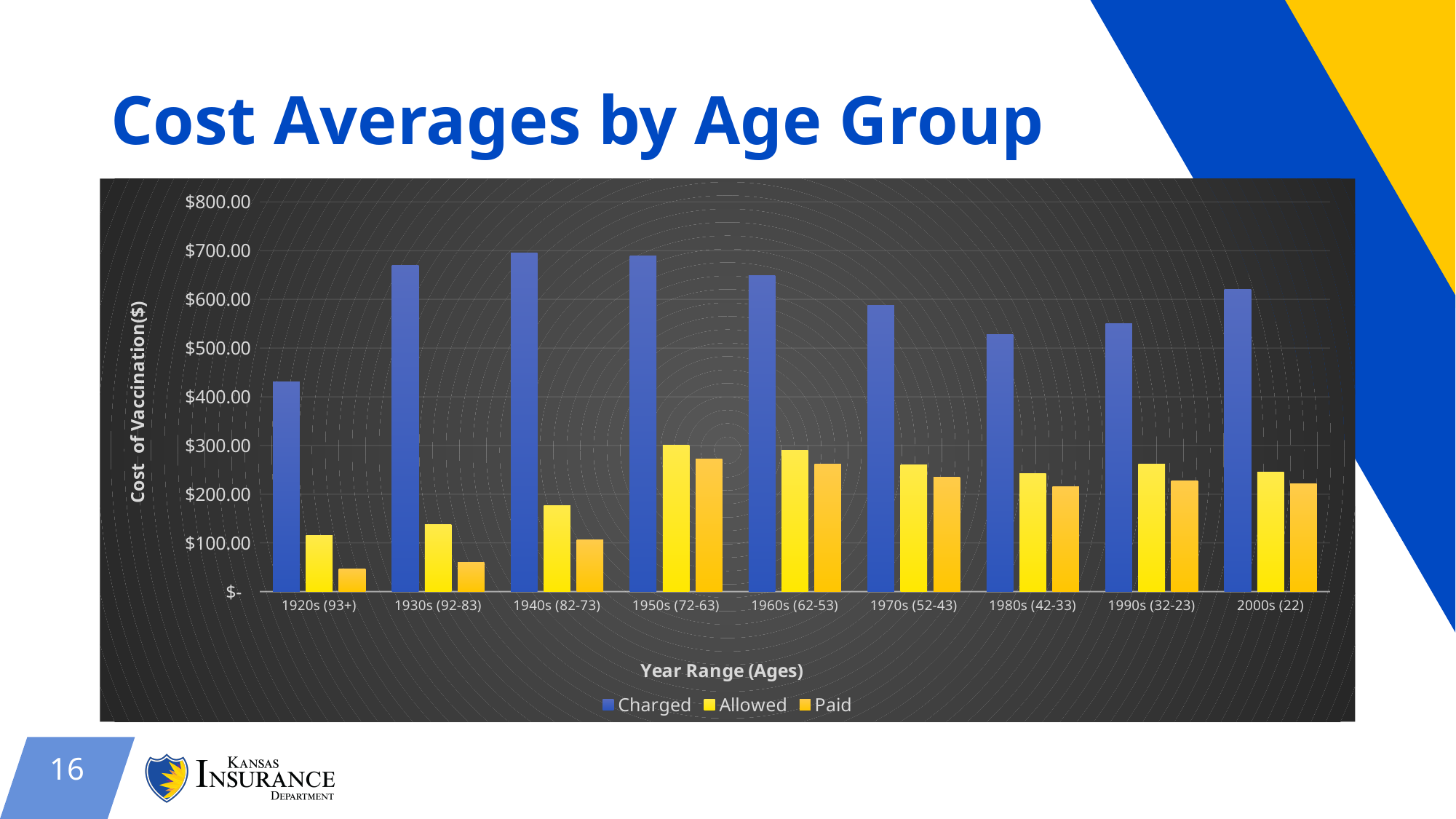
Which is larger, the Paid value for 1940s (82-73) or for 1950s (72-63)? 1950s (72-63) Is the Paid value for 1920s (93+) greater or less than $100.00? less Is the Allowed value for 1950s (72-63) greater or less than $200.00? greater What is the title of the y axis? Cost of Vaccination($) Is the Charged value for 1980s (42-33) greater or less than $600.00? less Which is larger, the Charged value for 1920s (93+) or for 1930s (92-83)? 1930s (92-83) Which year range has the lowest Paid value? 1920s (93+) What kind of chart is shown on the slide? bar chart How many year-range categories are shown on the x axis? 9 How many series does the legend list? 3 Which year range has the lowest Charged value? 1920s (93+)